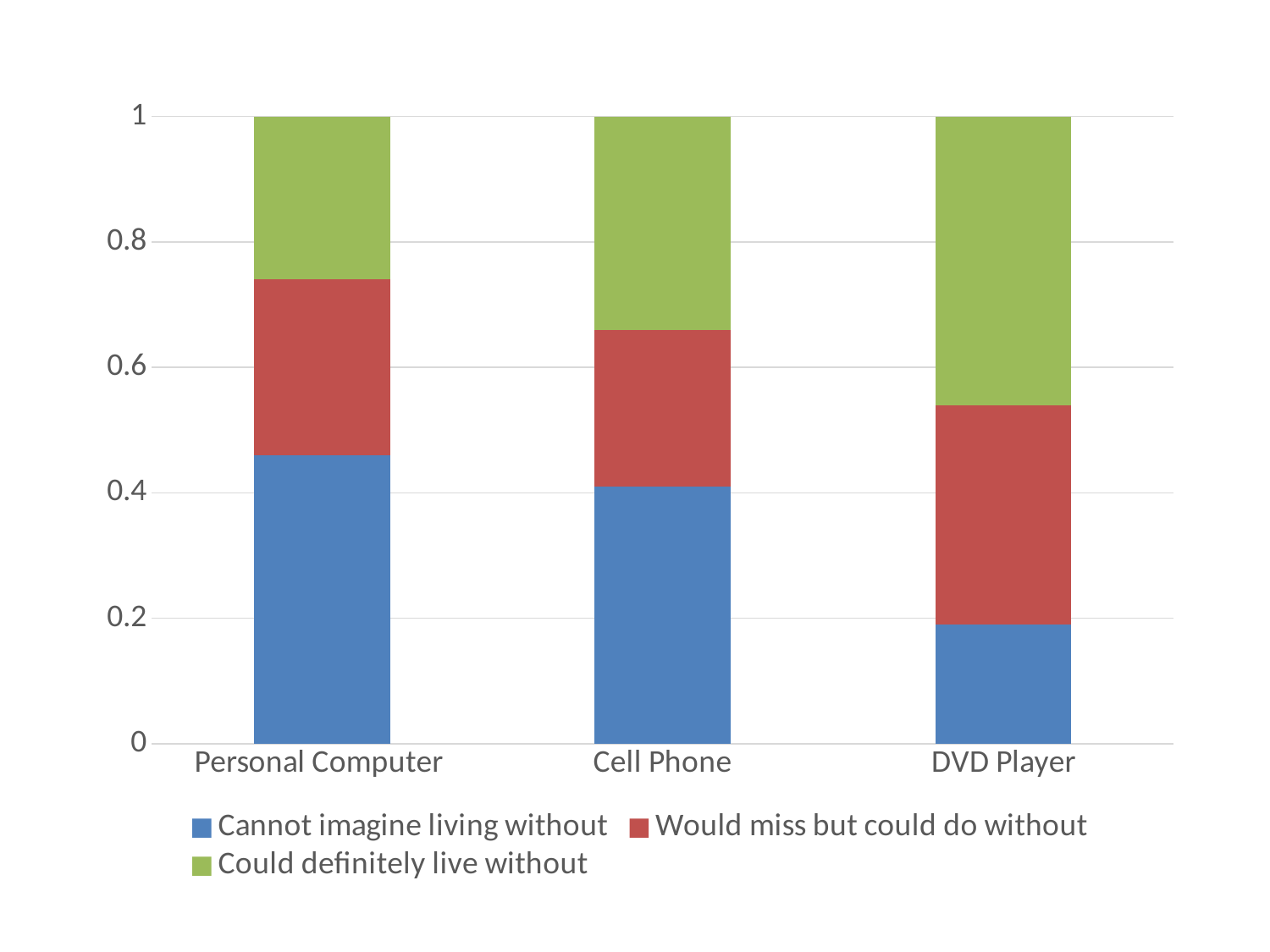
Which category has the largest "Could definitely live without" segment? DVD Player Is the "Cannot imagine living without" value for Personal Computer greater or less than 0.4? greater Is the "Cannot imagine living without" segment larger for Personal Computer or for DVD Player? Personal Computer What colour represents "Could definitely live without" in the legend? Green How many categories are shown on the x axis? 3 Is the "Cannot imagine living without" value for DVD Player greater or less than 0.4? less Which category has the smallest "Cannot imagine living without" segment? DVD Player Which category has the largest "Would miss but could do without" segment? DVD Player Which category has the smallest "Could definitely live without" segment? Personal Computer What kind of chart is shown on the slide? Stacked bar chart How many series does the legend list? 3 Do the "Cannot imagine living without" segments rise or fall from Personal Computer to DVD Player? fall